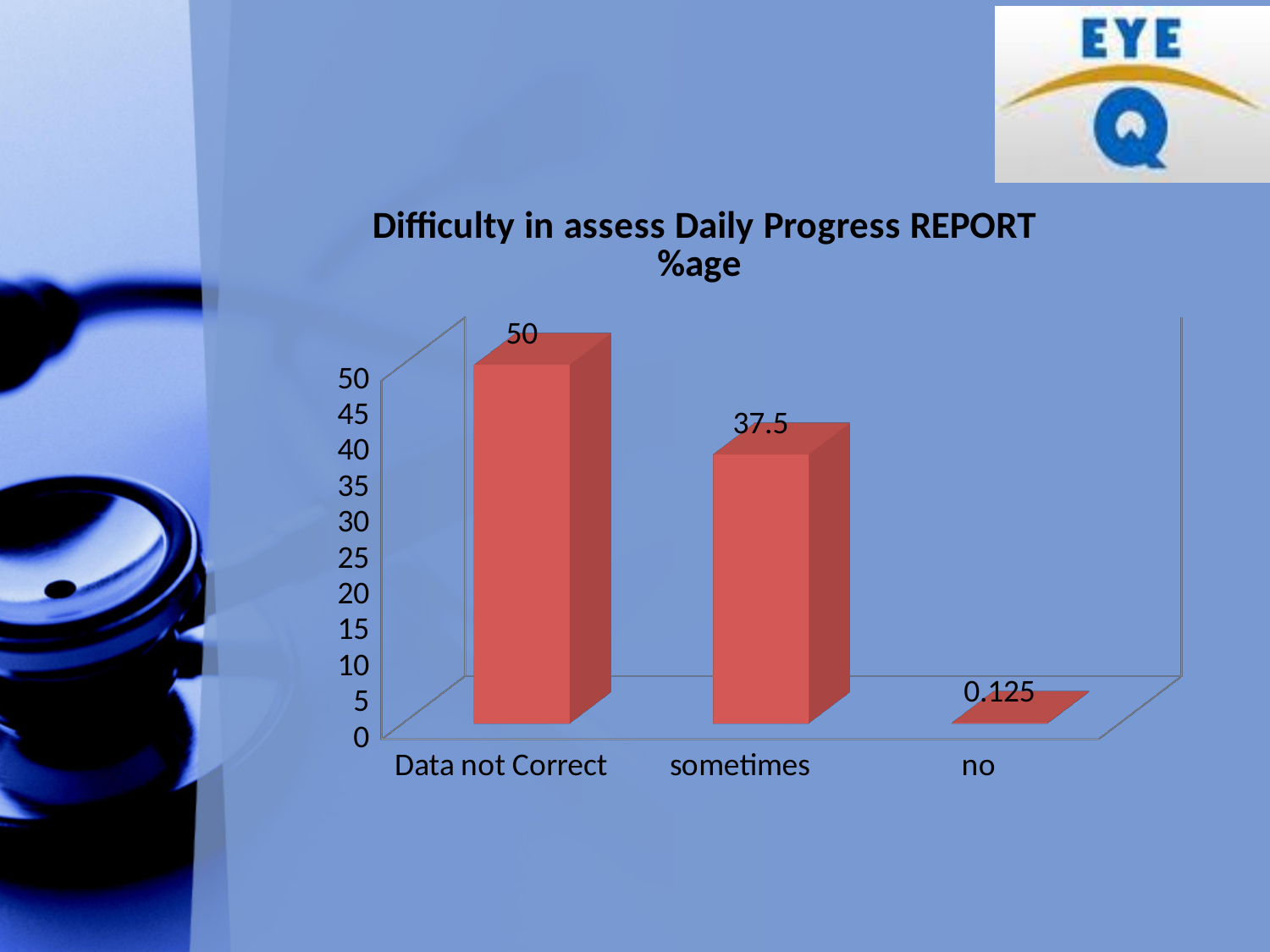
Which category has the highest value? Data not Correct What is the value for "sometimes"? 37.5 What is the difference between the values for "Data not Correct" and "sometimes"? 12.5 Do the values rise or fall from left to right along the x axis? Fall Which category has the lowest value? no Which is larger, the value for "sometimes" or the value for "no"? sometimes What is the value for "Data not Correct"? 50 What kind of chart is shown on the slide? Bar chart What is the value for "no"? 0.125 What is the title of the chart? Difficulty in assess Daily Progress REPORT %age Is the value for "sometimes" greater or less than 30? greater How many categories are shown on the x axis? 3